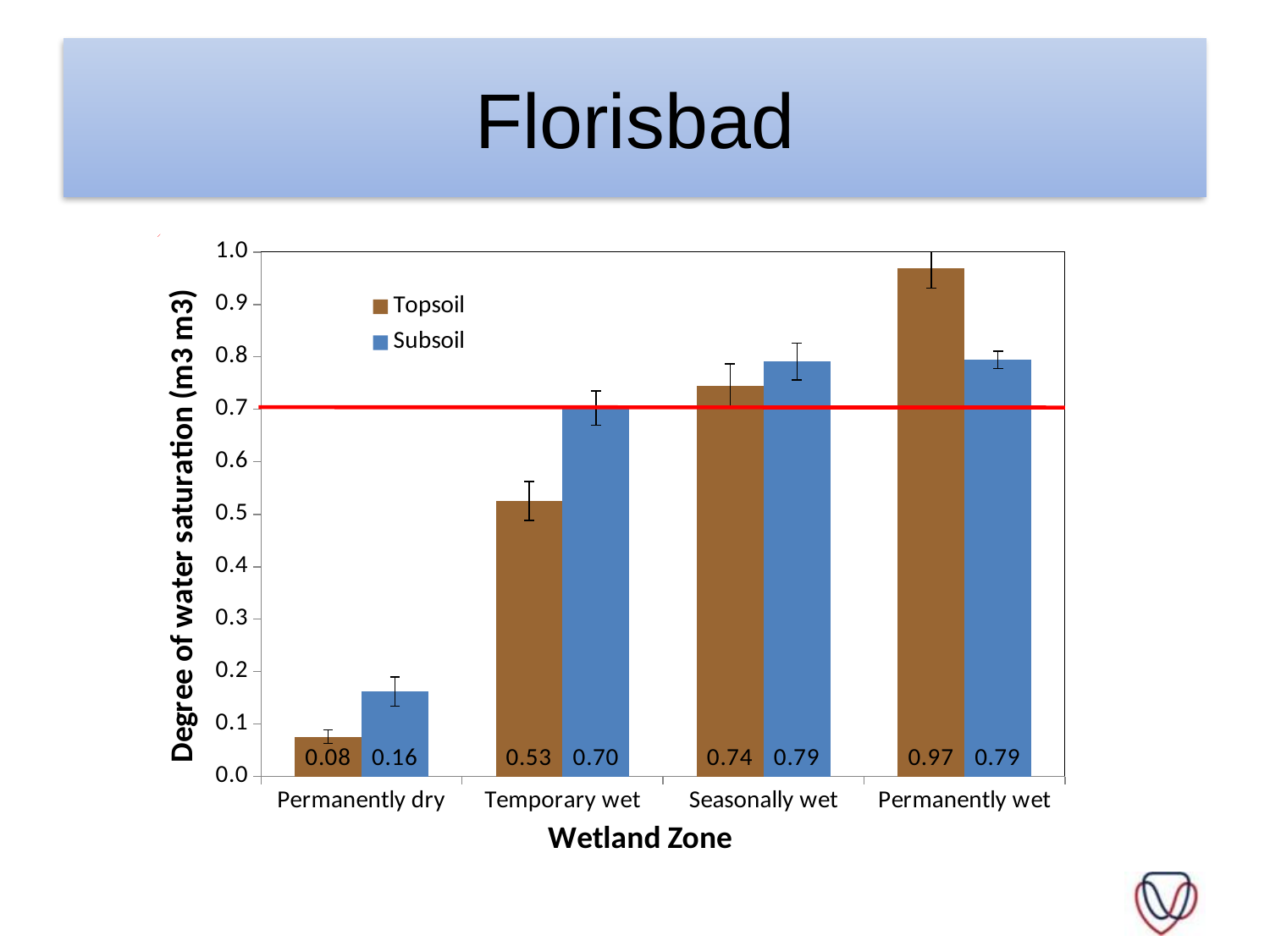
What kind of chart is shown on the slide? Bar chart What is the Subsoil value for Temporary wet? 0.70 Which wetland zone has the highest Topsoil value? Permanently wet How many wetland zones are shown on the x axis? 4 What is the difference between the Subsoil and Topsoil values for Temporary wet? 0.17 What is the Subsoil value for Seasonally wet? 0.79 What is the Topsoil value for Permanently dry? 0.08 How many series does the legend list? 2 What is the label of the y axis? Degree of water saturation (m3 m3) Which wetland zone has the lowest Subsoil value? Permanently dry What is the Topsoil value for Permanently wet? 0.97 Which is larger for Permanently wet, the Topsoil value or the Subsoil value? Topsoil